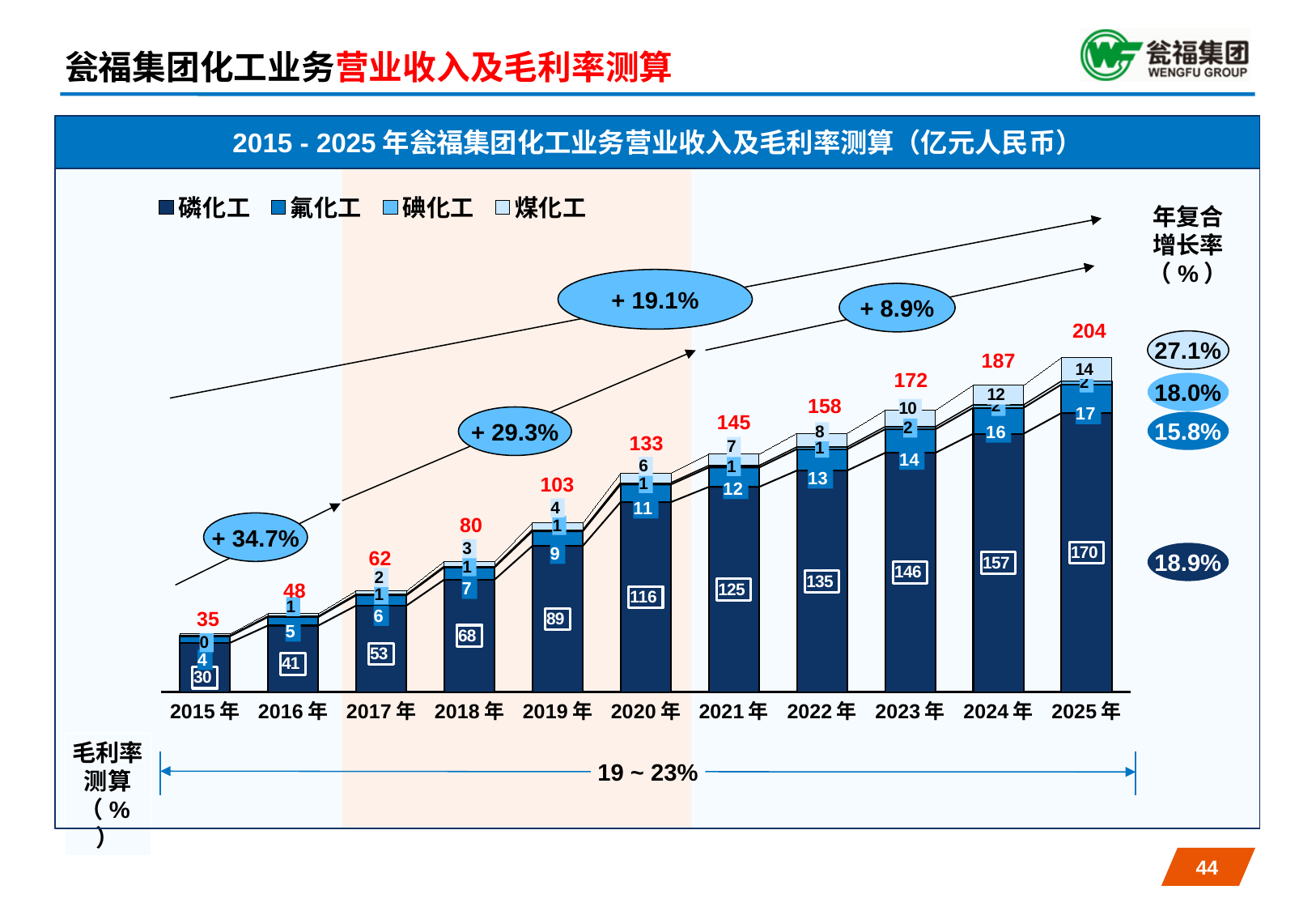
What is the value of 氟化工 in 2024年? 16 What kind of chart is this? stacked bar chart What is the value of 煤化工 in 2023年? 10 Which year has the highest total revenue? 2025年 How many series does the legend list? 4 How many years are shown on the x axis? 11 What is the difference between the total revenue in 2025年 and 2015年? 169 Which year has the lowest total revenue? 2015年 What is the total revenue shown above the bar for 2025年? 204 What is the value of 磷化工 in 2020年? 116 Do the total revenue values rise or fall from 2015年 to 2025年? rise Which is larger, the 磷化工 value in 2019年 or in 2018年? 2019年